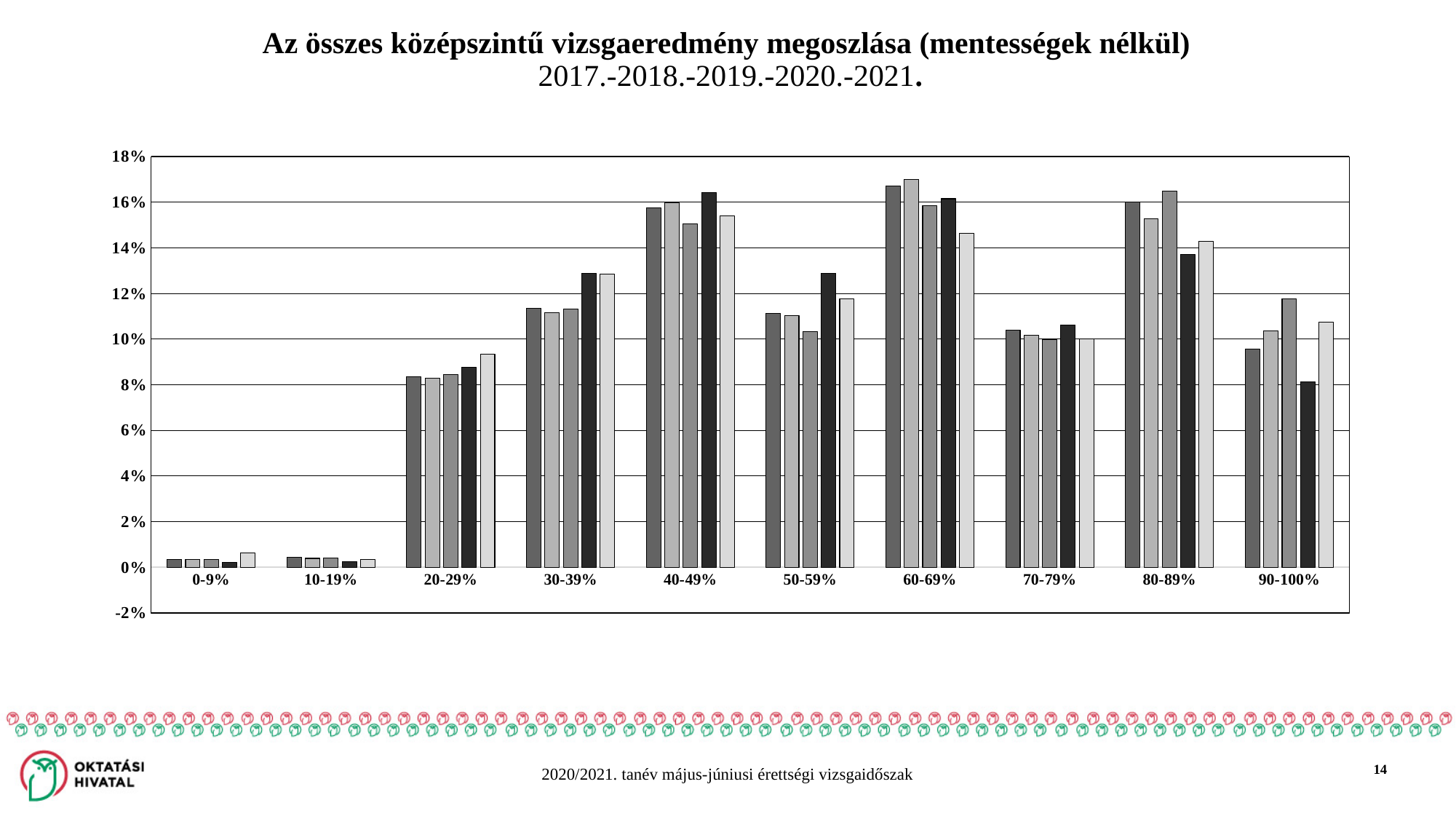
Is the black bar in the 90-100% group greater or less than 10%? less Which score-range category contains the tallest bar in the chart? 60-69% Are the bars in the 0-9% group greater or less than 2%? less Is the black bar in the 50-59% group greater or less than 12%? greater What is the highest value labelled on the y axis? 18% How many bars are plotted for each score-range category? 5 What kind of chart is shown on the slide? bar chart Which years are listed in the chart title? 2017, 2018, 2019, 2020, 2021 How many score-range categories are shown on the x axis? 10